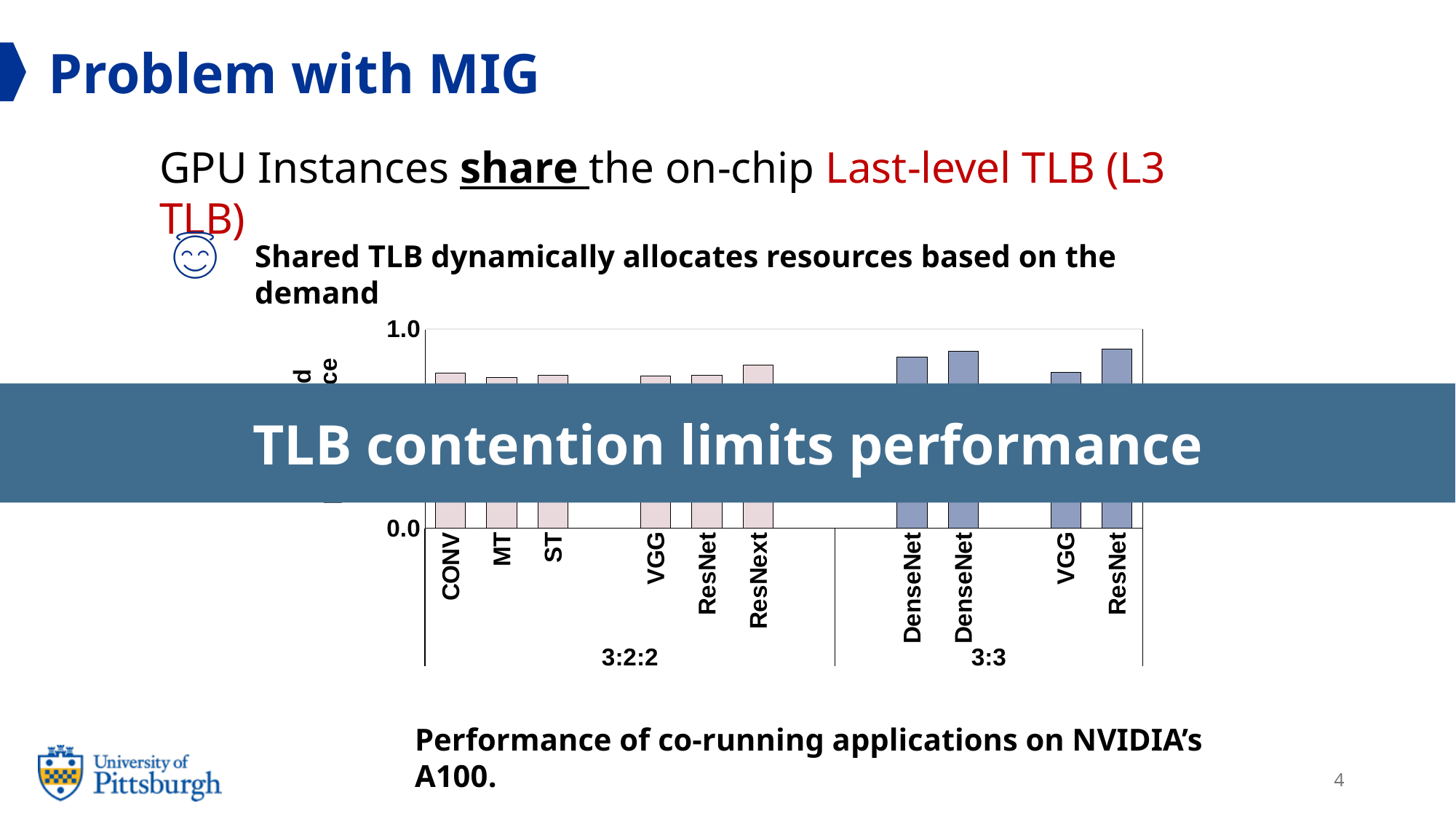
Which is larger, the value for ResNet in the 3:3 group or the value for VGG in the 3:3 group? ResNet Which is larger, the value for the first DenseNet bar in the 3:3 group or the value for CONV in the 3:2:2 group? DenseNet How many bars are in the 3:3 group of the chart? 4 What kind of chart is shown on the slide? bar chart How many application groups are labelled along the x axis of the chart? 2 Is the value for ResNet in the 3:3 group greater or less than 1.0? less Is the value for MT in the 3:2:2 group greater or less than 1.0? less What is the highest tick value shown on the y axis of the chart? 1.0 How many bars are plotted in the chart? 10 What are the two group labels shown beneath the x axis of the chart? 3:2:2 and 3:3 Which is larger, the value for ResNext in the 3:2:2 group or the value for MT? ResNext